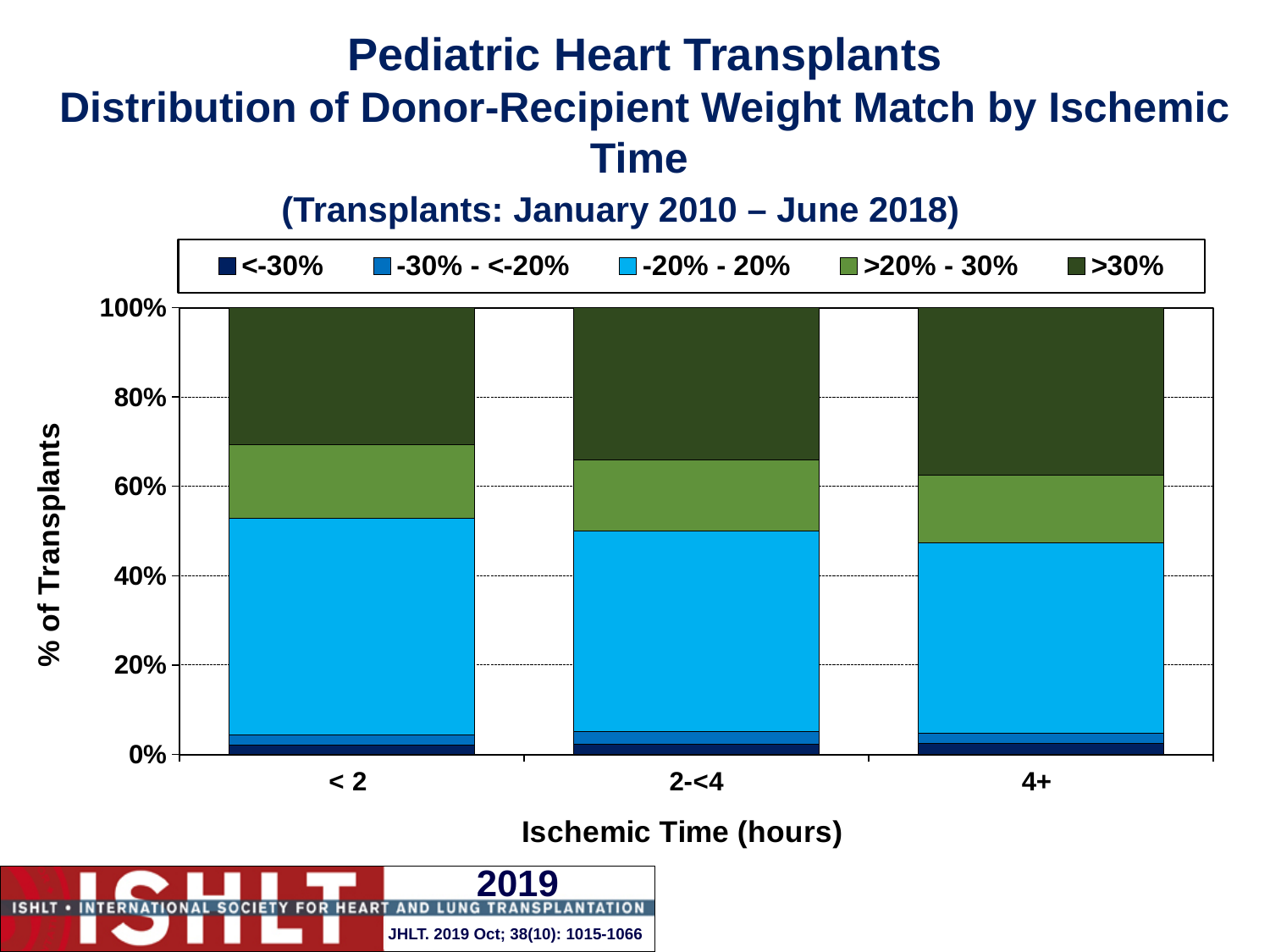
Is the top of the -20% - 20% segment for the 4+ hours bar greater or less than 60%? less What is the total height of each stacked bar? 100% What is the label of the x axis? Ischemic Time (hours) How many ischemic time categories are shown on the x axis? 3 What is the label of the y axis? % of Transplants Is the top of the >20% - 30% segment for the 2-<4 hours bar greater or less than 80%? less Which ischemic time category has the largest >30% segment? 4+ Is the >30% segment larger for the < 2 hours bar or the 4+ hours bar? 4+ Is the top of the -20% - 20% segment for the < 2 hours bar greater or less than 40%? greater How many series does the legend list? 5 Does the share of the >30% weight match group rise or fall as ischemic time increases along the x axis? rise What kind of chart is shown on the slide? stacked bar chart